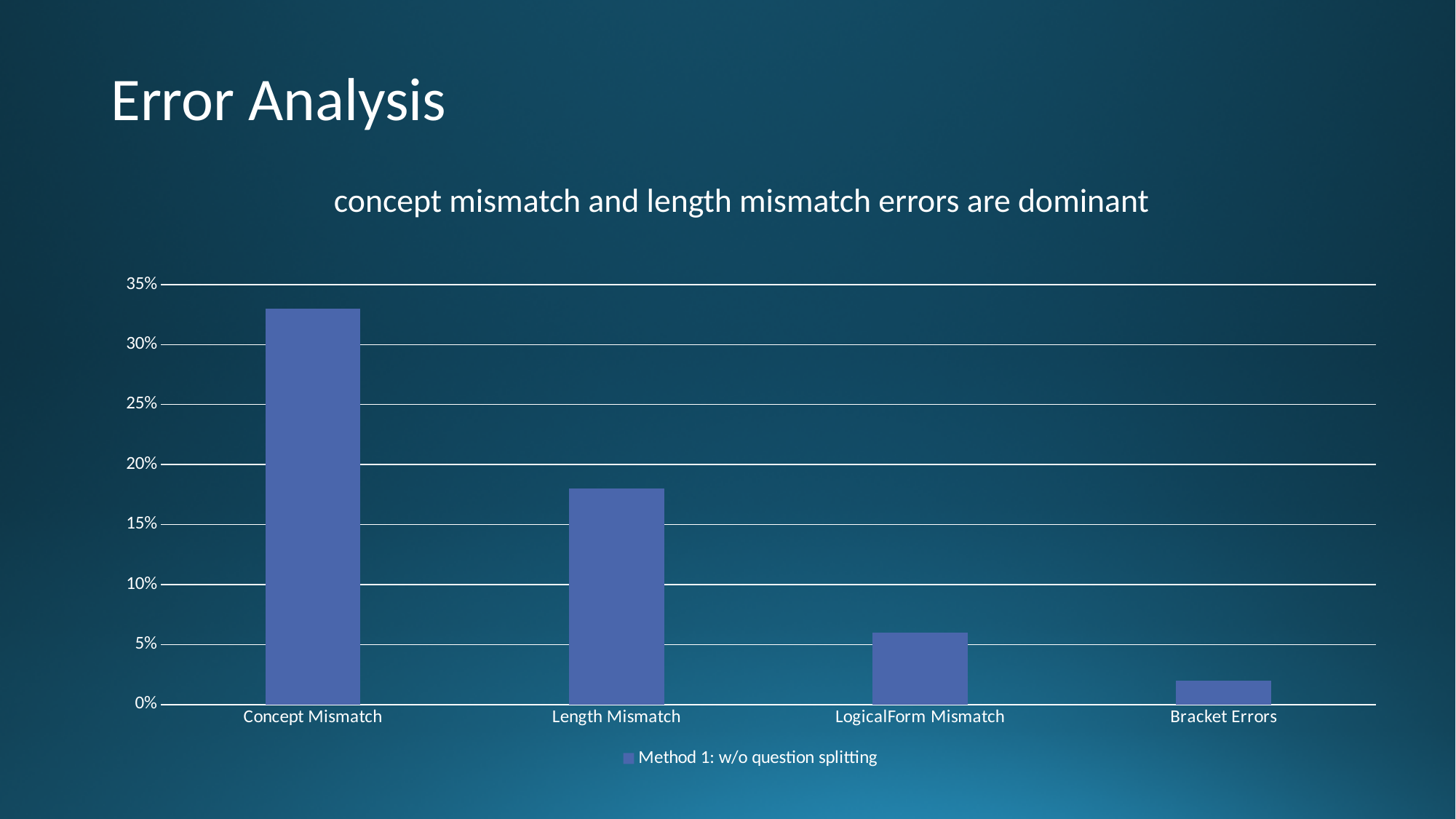
Is the value for Bracket Errors greater or less than 5%? less Which error category has the highest value? Concept Mismatch Is the value for LogicalForm Mismatch greater or less than 5%? greater How many series does the legend list? 1 What kind of chart is shown on the slide? bar chart Is the value for Length Mismatch greater or less than 20%? less How many error categories are shown on the x axis? 4 Which is larger, the value for Concept Mismatch or the value for Length Mismatch? Concept Mismatch Which is larger, the value for Length Mismatch or the value for LogicalForm Mismatch? Length Mismatch Do the values rise or fall from left to right along the x axis? fall Which error category has the lowest value? Bracket Errors